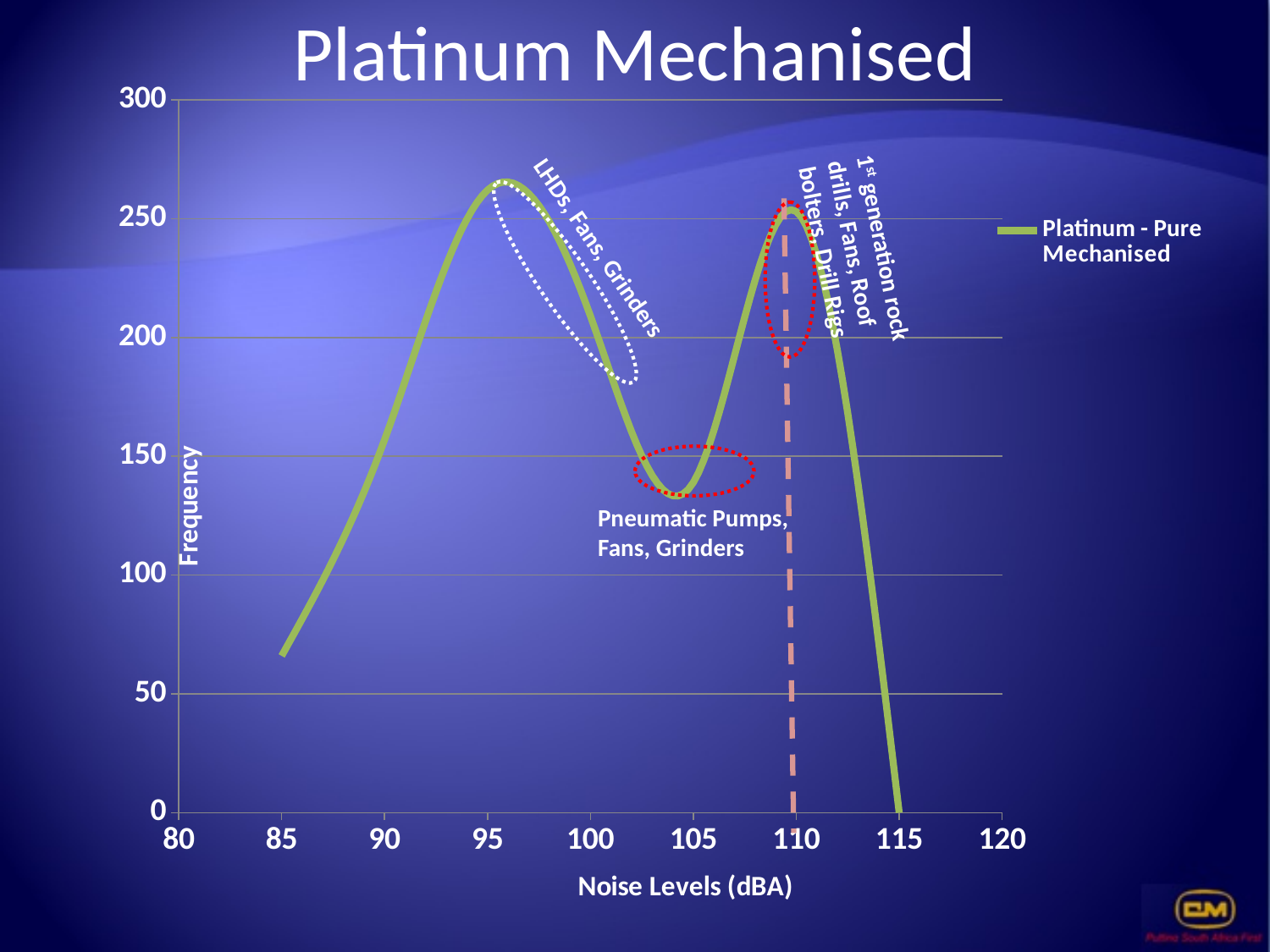
Is the frequency at 95 dBA greater or less than 200? greater Is the frequency at 85 dBA greater or less than 100? less Is the frequency at 115 dBA greater or less than 50? less Does the frequency rise or fall as noise level increases from 110 to 115 dBA? fall Does the frequency rise or fall as noise level increases from 85 to 95 dBA? rise Which is larger, the frequency at 85 dBA or at 105 dBA? 105 dBA How many series does the legend list? 1 What kind of chart is shown on the slide? line chart What is the title of the x axis? Noise Levels (dBA) What is the name of the series shown in the legend? Platinum - Pure Mechanised